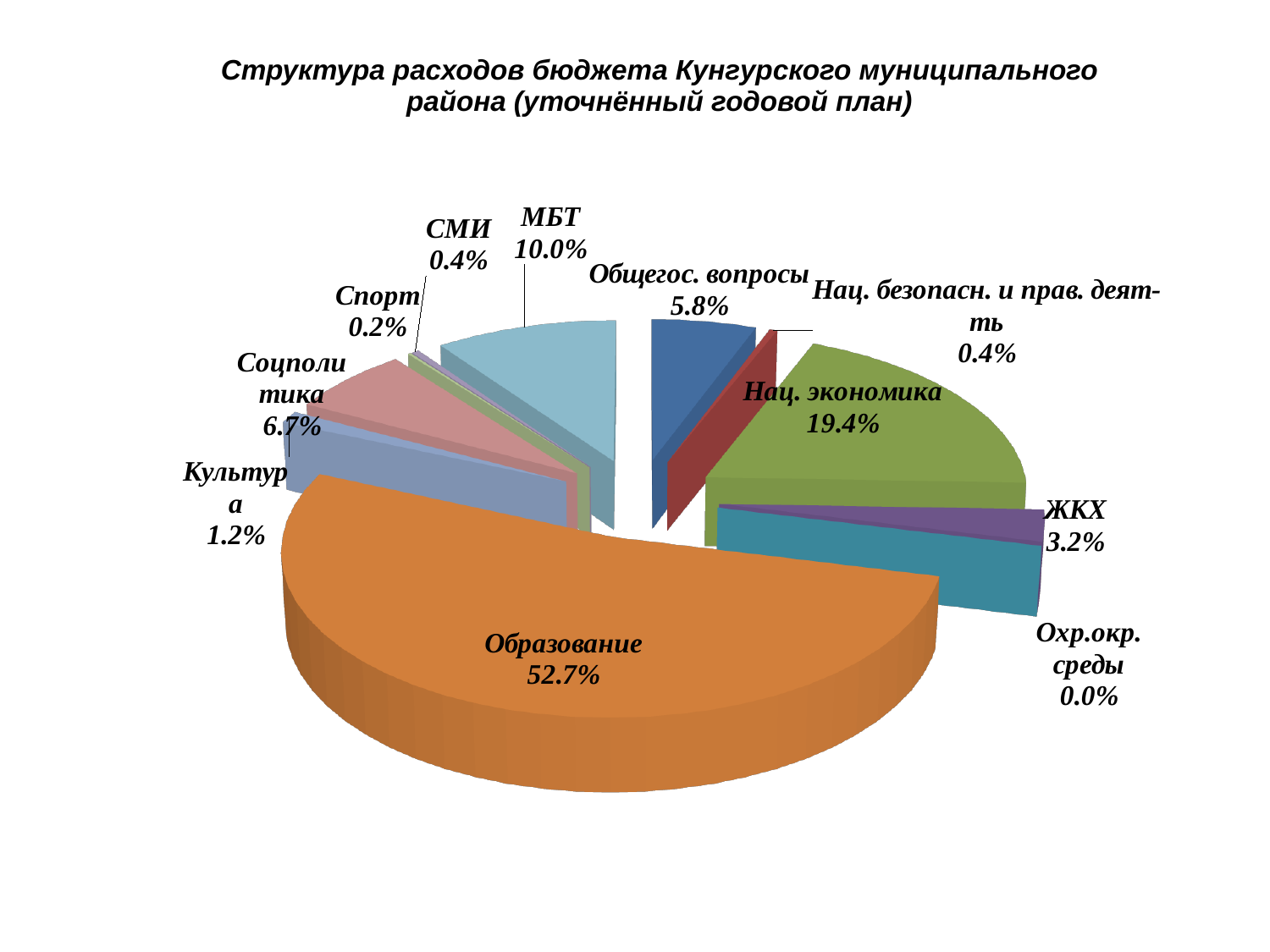
What share of the budget expenditure goes to Образование? 52.7% What share of the budget expenditure goes to МБТ? 10.0% What share of the budget expenditure goes to ЖКХ? 3.2% Which has a larger share, Общегос. вопросы or Соцполитика? Соцполитика What share of the budget expenditure goes to Соцполитика? 6.7% Which category has the smallest share of the budget expenditure? Охр.окр. среды What is the title of the chart? Структура расходов бюджета Кунгурского муниципального района (уточнённый годовой план) What kind of chart is shown on the slide? Pie chart What is the difference between the shares of Образование and Нац. экономика? 33.3% How many categories are shown in the pie chart? 11 Which category has the largest share of the budget expenditure? Образование What share of the budget expenditure goes to Нац. экономика? 19.4%